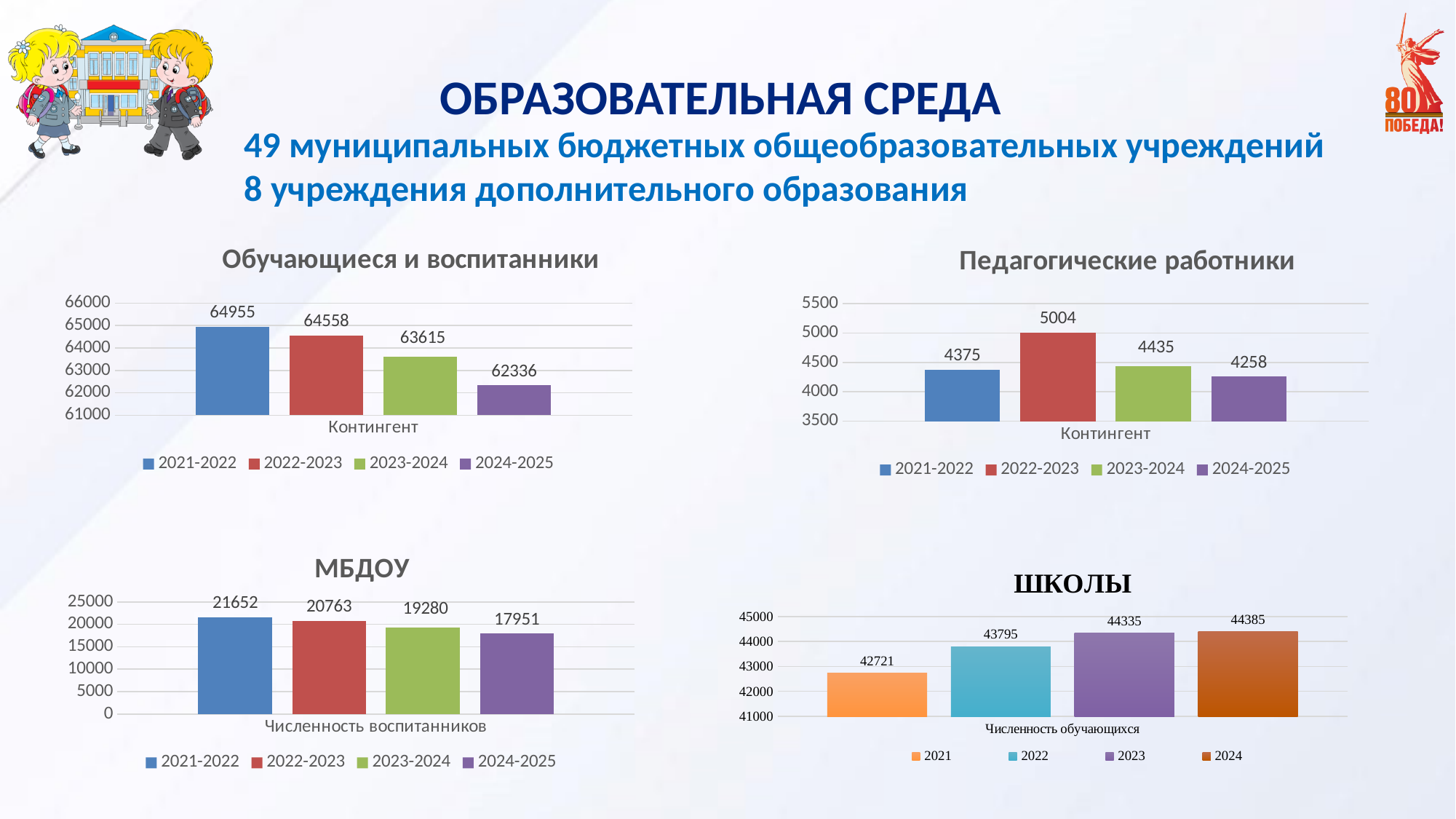
In the chart titled 'ШКОЛЫ', what is the value for 2022? 43795 In the chart titled 'МБДОУ', what is the value for 2023-2024? 19280 In the chart titled 'Обучающиеся и воспитанники', do the values rise or fall from 2021-2022 to 2024-2025? fall In the chart titled 'МБДОУ', which series has the lowest value? 2024-2025 In the chart titled 'Обучающиеся и воспитанники', what is the value for 2021-2022? 64955 In the chart titled 'МБДОУ', how many series does the legend list? 4 In the chart titled 'ШКОЛЫ', what is the difference between the 2024 and 2021 values? 1664 What kind of chart is the chart titled 'ШКОЛЫ'? bar chart In the chart titled 'Педагогические работники', which series has the highest value? 2022-2023 In the chart titled 'Педагогические работники', what is the value for 2024-2025? 4258 In the chart titled 'Педагогические работники', which is larger: the value for 2021-2022 or for 2023-2024? 2023-2024 In the chart titled 'Обучающиеся и воспитанники', what is the difference between the 2021-2022 and 2024-2025 values? 2619